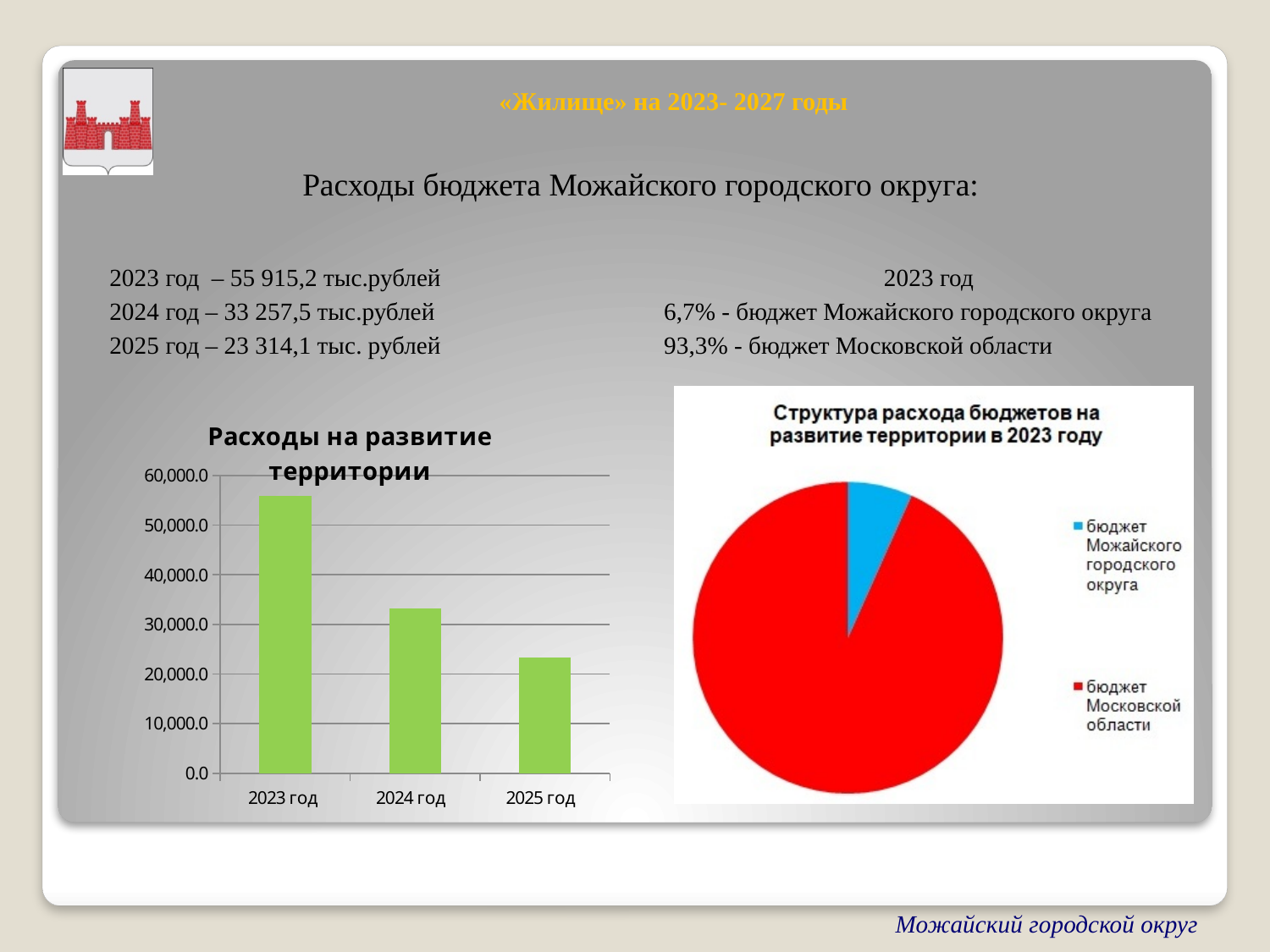
What kind of chart is the chart titled "Расходы на развитие территории"? bar chart In the bar chart "Расходы на развитие территории", which is larger, the bar for 2024 год or the bar for 2025 год? 2024 год What kind of chart is the chart titled "Структура расхода бюджетов на развитие территории в 2023 году"? pie chart In the bar chart "Расходы на развитие территории", which year has the lowest bar? 2025 год In the bar chart "Расходы на развитие территории", is the value for 2024 год greater or less than 40,000.0? less In the pie chart "Структура расхода бюджетов на развитие территории в 2023 году", which slice is larger, "бюджет Московской области" or "бюджет Можайского городского округа"? бюджет Московской области In the bar chart "Расходы на развитие территории", how many years are shown on the x axis? 3 In the pie chart "Структура расхода бюджетов на развитие территории в 2023 году", how many entries does the legend list? 2 In the bar chart "Расходы на развитие территории", is the value for 2025 год greater or less than 20,000.0? greater In the bar chart "Расходы на развитие территории", do the values rise or fall from 2023 год to 2025 год? fall In the bar chart "Расходы на развитие территории", is the value for 2023 год greater or less than 50,000.0? greater In the bar chart "Расходы на развитие территории", which year has the highest bar? 2023 год